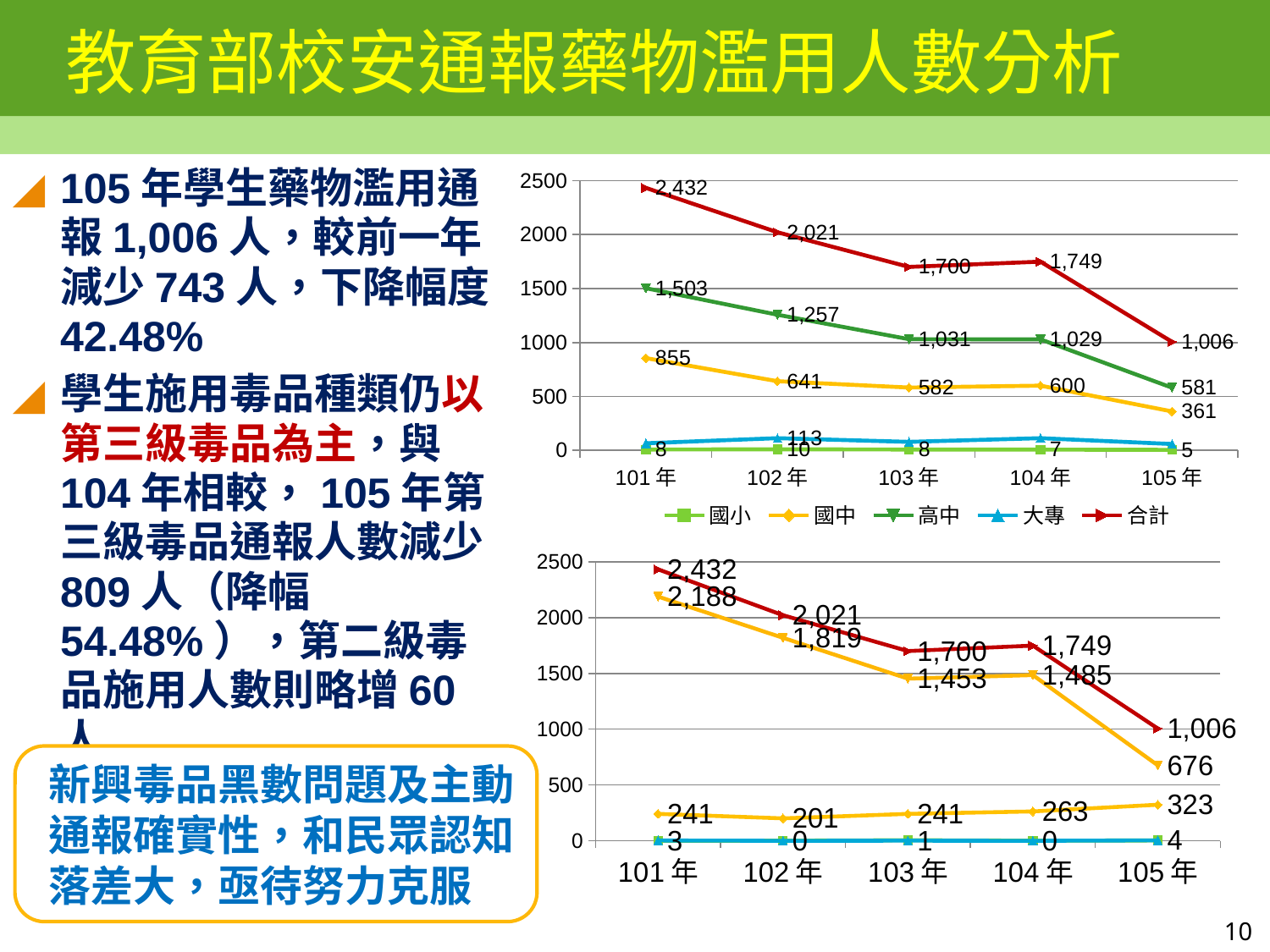
In the bottom chart, does the red line rise or fall from 101年 to 103年? fall In the top chart, which year has the lowest 合計 value? 105年 In the bottom chart, what is the difference between the orange line values for 101年 and 102年? 369 In the top chart, which is larger: 國中 for 102年 or 國中 for 104年? 國中 for 102年 In the top chart, what is the value of 合計 for 101年? 2,432 In the top chart, how many years are shown on the x axis? 5 In the top chart, what is the value of 高中 for 103年? 1,031 In the bottom chart, what is the value of the orange line for 105年? 676 In the top chart, what is the value of 國中 for 105年? 361 What kind of chart is the top chart? line chart In the top chart, what is the difference between the 合計 values for 104年 and 105年? 743 In the top chart, how many series does the legend list? 5